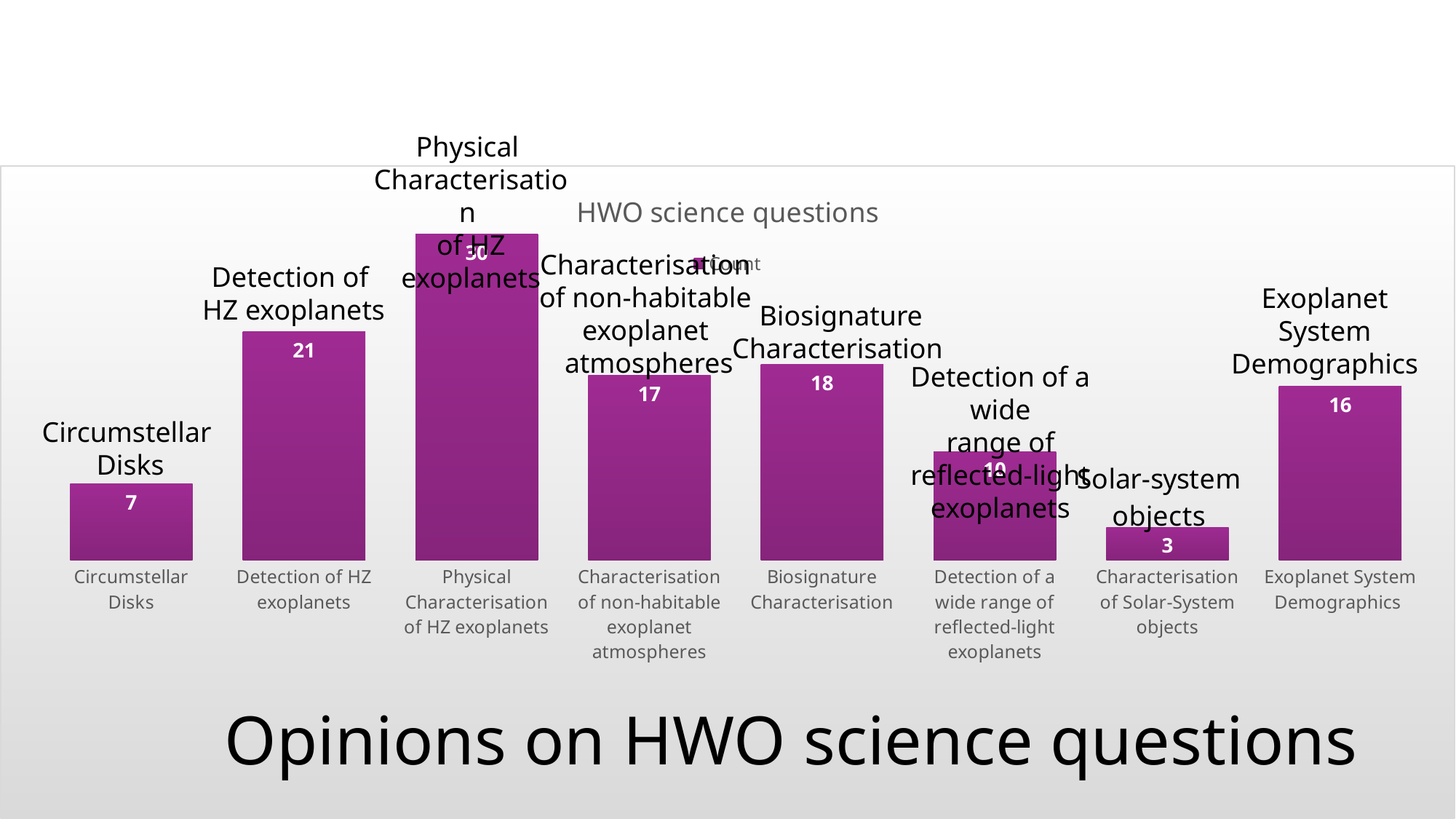
Which category has the highest value? Physical Characterisation of HZ exoplanets What is the value for Exoplanet System Demographics? 16 How many categories are shown in the chart? 8 What is the title of the chart? HWO science questions What is the difference between the values for Detection of HZ exoplanets and Circumstellar Disks? 14 What is the value for Biosignature Characterisation? 18 Which category has the lowest value? Characterisation of Solar-System objects What kind of chart is shown on the slide? Bar chart What is the value for Circumstellar Disks? 7 What is the value for Detection of HZ exoplanets? 21 What is the value for Characterisation of non-habitable exoplanet atmospheres? 17 Which is larger, the value for Biosignature Characterisation or the value for Characterisation of non-habitable exoplanet atmospheres? Biosignature Characterisation